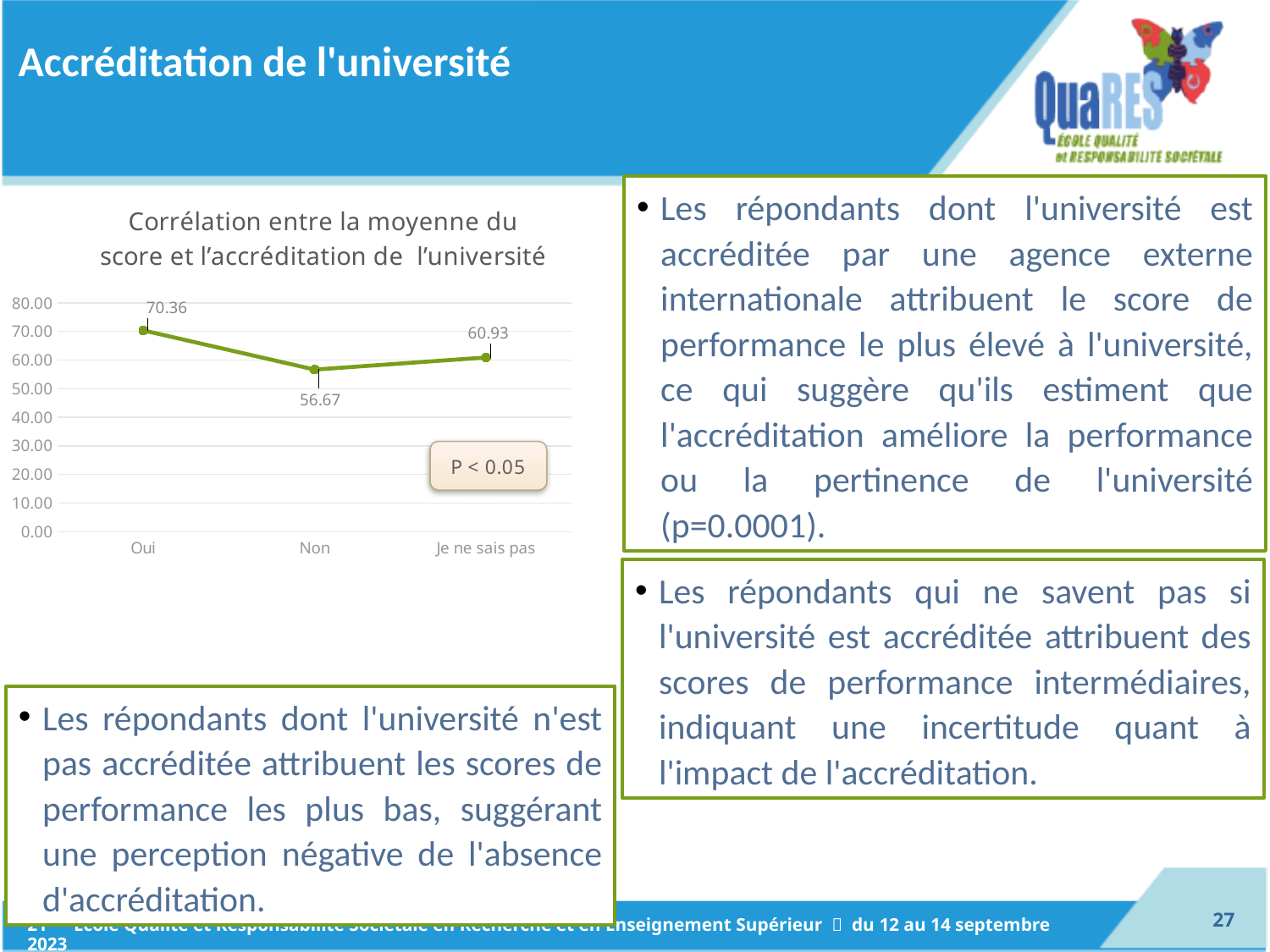
Which category has the highest value in the chart? Oui What is the value for "Non" in the chart? 56.67 What is the difference between the values for "Oui" and "Non"? 13.69 What is the value for "Je ne sais pas" in the chart? 60.93 How many categories are shown on the x axis of the chart? 3 Is the value for "Non" greater or less than 60.00? less What kind of chart is shown on the slide? line chart What is the difference between the values for "Je ne sais pas" and "Non"? 4.26 What p-value annotation is shown on the chart? P < 0.05 Which category has the lowest value in the chart? Non What is the value for "Oui" in the chart? 70.36 Which is larger, the value for "Oui" or the value for "Je ne sais pas"? Oui